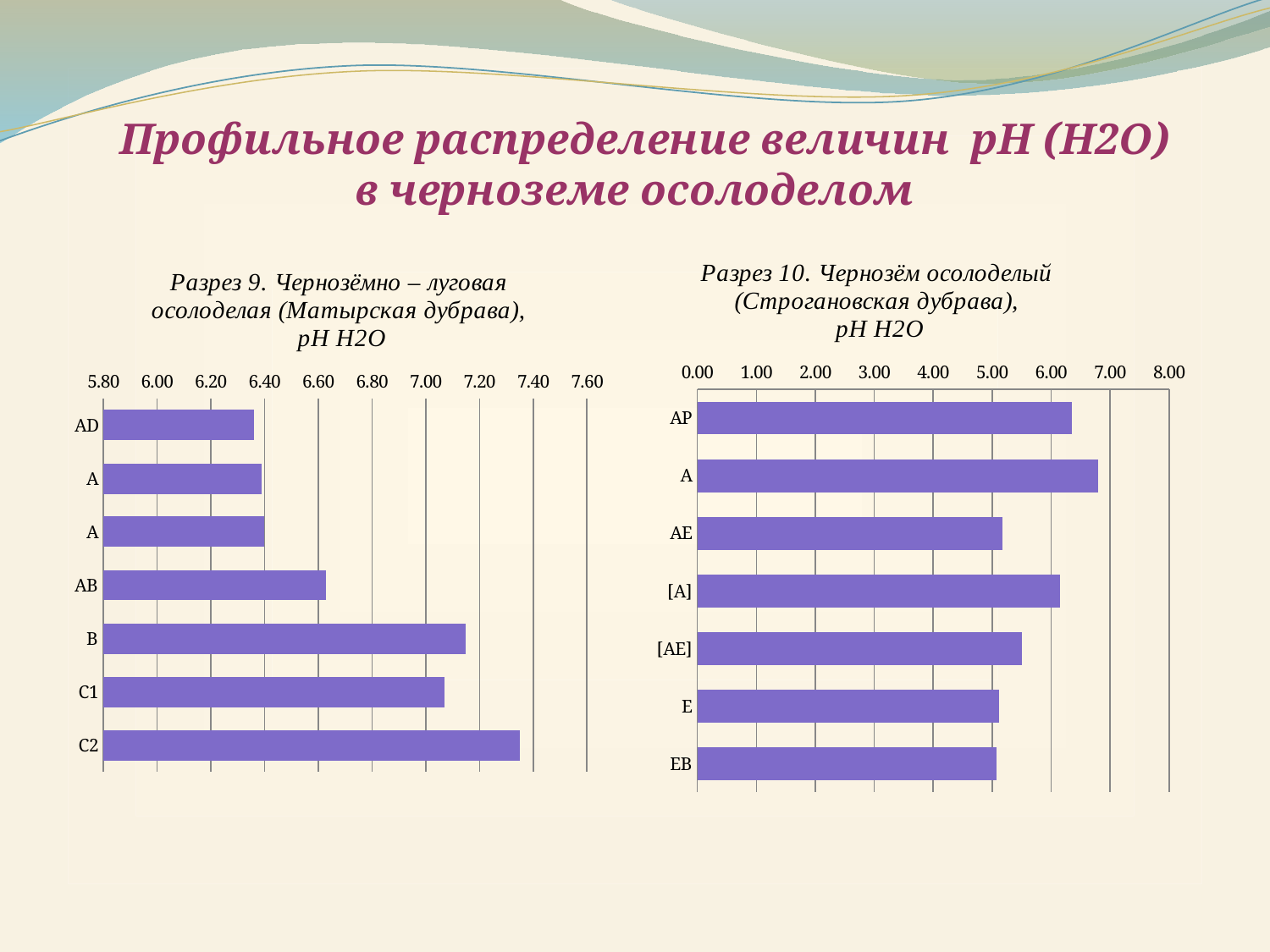
In the right chart, 'Разрез 10', which horizon has the highest pH value? A In the left chart, 'Разрез 9', is the value for B greater or less than 7.00? greater In the left chart, 'Разрез 9', which horizon has the highest pH value? C2 In the left chart, 'Разрез 9', which is larger, the value for B or the value for AB? B In the right chart, 'Разрез 10', is the value for [AE] greater or less than 6.00? less In the right chart, 'Разрез 10', which is larger, the value for AP or the value for [AE]? AP How many soil horizons (bars) are shown in the right chart, 'Разрез 10'? 7 What kind of chart is the left chart, 'Разрез 9. Чернозёмно – луговая осолоделая (Матырская дубрава), pH H2O'? bar chart In the right chart, 'Разрез 10', is the value for A greater or less than 6.00? greater What is the title of the right chart? Разрез 10. Чернозём осолоделый (Строгановская дубрава), pH H2O How many soil horizons (bars) are shown in the left chart, 'Разрез 9'? 7